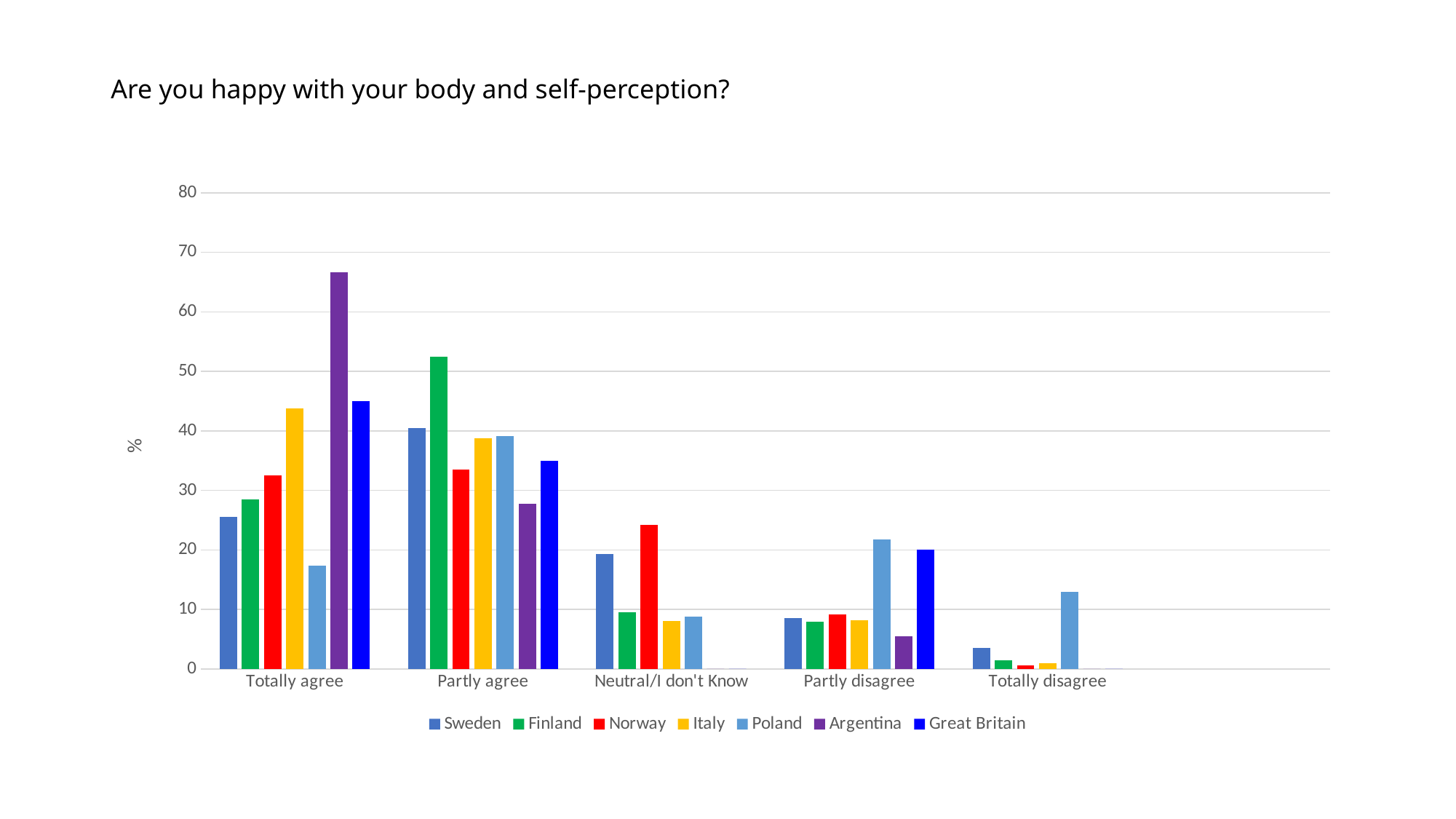
Is the value for Argentina under "Totally agree" greater or less than 60? greater How many series does the legend list? 7 What is the label on the y axis? % Which country has the highest value for "Totally disagree"? Poland How many response categories are shown on the x axis? 5 Which country has the highest value for "Partly agree"? Finland Which country has the lowest value for "Totally agree"? Poland Which country has the highest value for "Totally agree"? Argentina Is the value for Poland under "Totally disagree" greater or less than 10? greater Under "Neutral/I don't Know", which is larger: Norway or Sweden? Norway What kind of chart is shown on the slide? bar chart Is the value for Finland under "Partly agree" greater or less than 50? greater